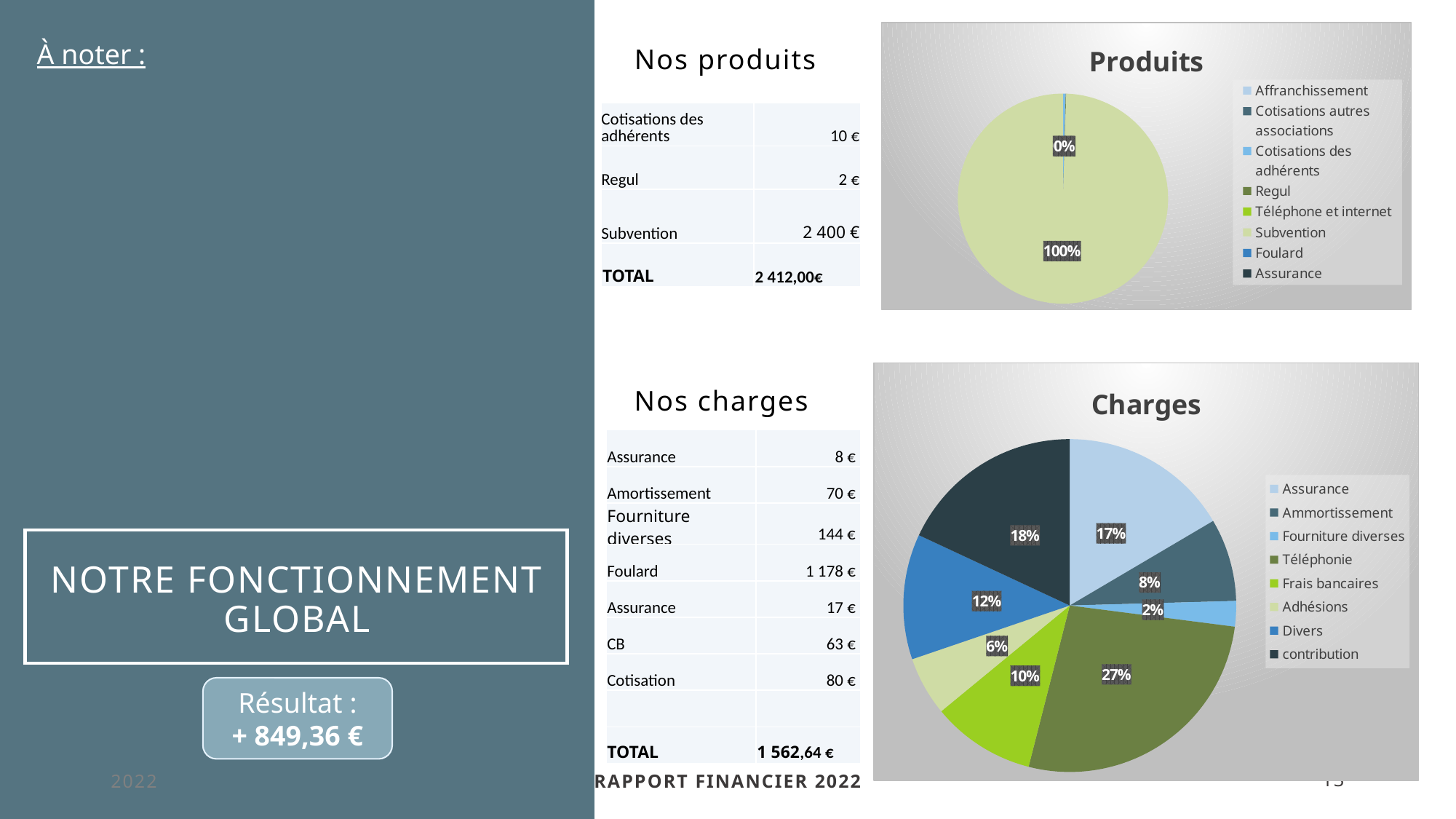
In the "Charges" chart, which category has the smallest share? Fourniture diverses In the "Charges" chart, what share does Assurance have? 17% In the "Charges" chart, what share does Téléphonie have? 27% How many entries does the legend of the "Charges" chart list? 8 In the "Produits" chart, what share does Subvention have? 100% What type of chart is the "Charges" chart? pie chart In the "Charges" chart, which category has the largest share? Téléphonie In the "Charges" chart, which is larger: Ammortissement or Adhésions? Ammortissement How many entries does the legend of the "Produits" chart list? 8 In the "Charges" chart, what is the difference in percentage points between contribution and Frais bancaires? 8 In the "Charges" chart, what share does Divers have? 12% In the "Charges" chart, what share does Fourniture diverses have? 2%